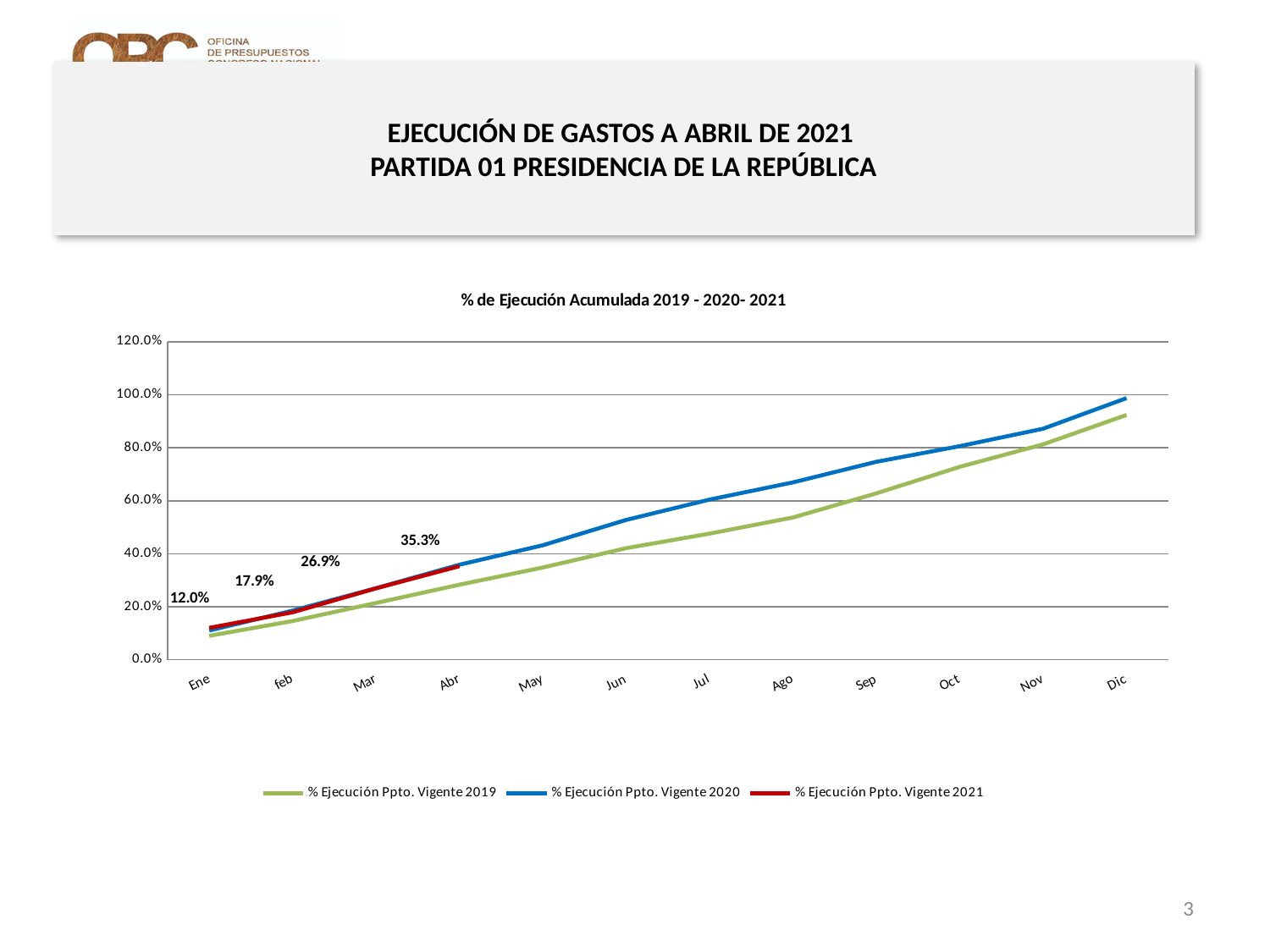
What is the value of % Ejecución Ppto. Vigente 2021 for Ene? 12.0% How many series does the legend list? 3 What is the value of % Ejecución Ppto. Vigente 2021 for Abr? 35.3% What is the value of % Ejecución Ppto. Vigente 2021 for Feb? 17.9% What is the title of the chart? % de Ejecución Acumulada 2019 - 2020- 2021 Is the value for % Ejecución Ppto. Vigente 2020 in Dic greater or less than 80.0%? greater How many months are shown on the x axis? 12 What is the value of % Ejecución Ppto. Vigente 2021 for Mar? 26.9% What is the difference between the 2021 values for Abr and Ene? 23.3% Do the values for % Ejecución Ppto. Vigente 2020 rise or fall from Ene to Dic? rise Which is larger in Dic: % Ejecución Ppto. Vigente 2019 or % Ejecución Ppto. Vigente 2020? % Ejecución Ppto. Vigente 2020 What kind of chart is shown on the slide? line chart